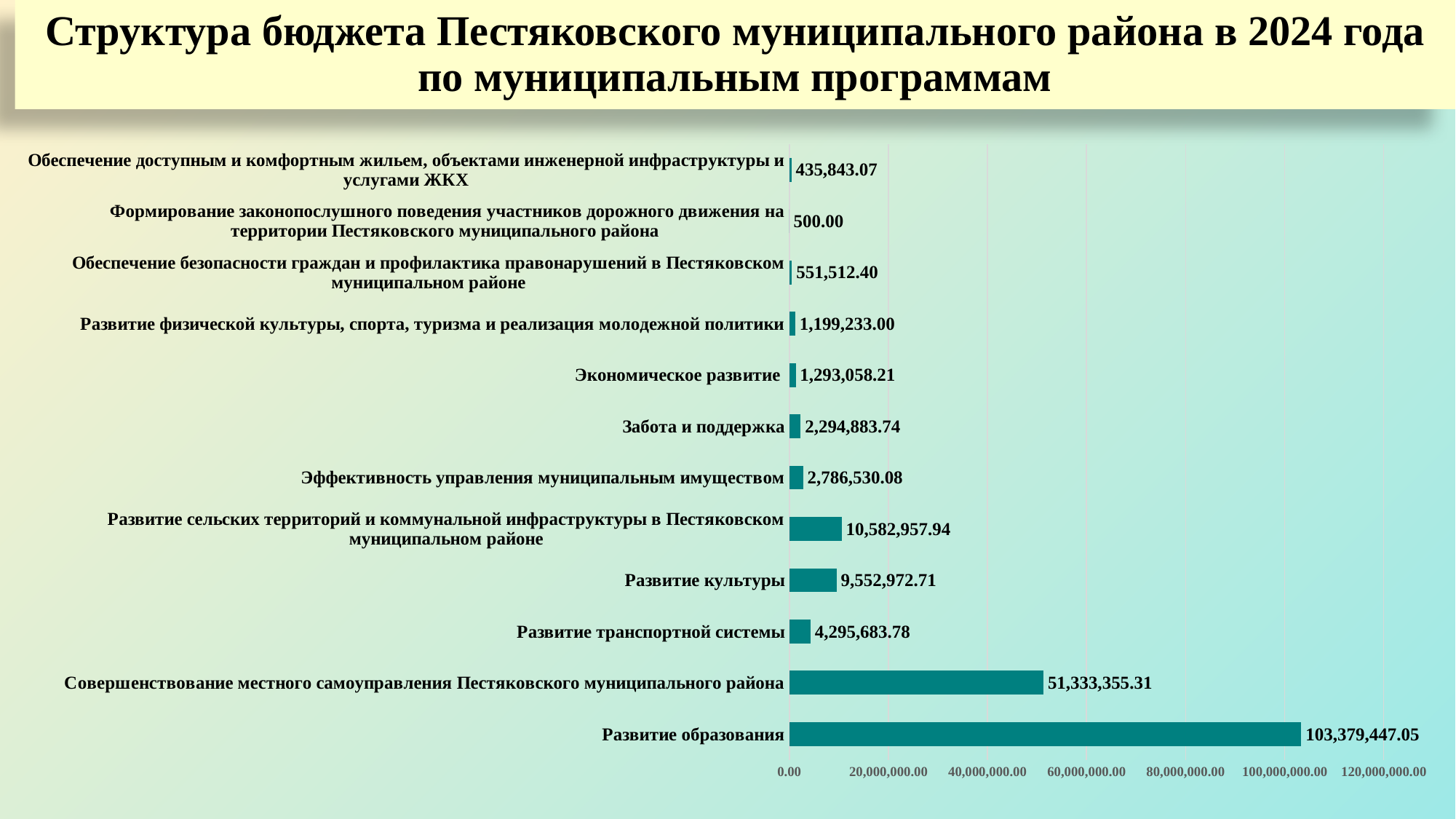
Which is larger: the value for Развитие культуры or the value for Развитие транспортной системы? Развитие культуры What is the value for Совершенствование местного самоуправления Пестяковского муниципального района? 51,333,355.31 What kind of chart is shown on the slide? Bar chart What is the value for Развитие культуры? 9,552,972.71 How many municipal programmes (categories) are plotted in the chart? 12 Which programme has the lowest value in the chart? Формирование законопослушного поведения участников дорожного движения на территории Пестяковского муниципального района Which programme has the highest value in the chart? Развитие образования What is the value for Развитие образования? 103,379,447.05 What is the difference between the values for Развитие образования and Совершенствование местного самоуправления Пестяковского муниципального района? 52,046,091.74 What is the difference between the values for Развитие сельских территорий и коммунальной инфраструктуры в Пестяковском муниципальном районе and Развитие культуры? 1,029,985.23 Is the value for Развитие образования greater or less than 100,000,000.00? greater What is the value for Забота и поддержка? 2,294,883.74